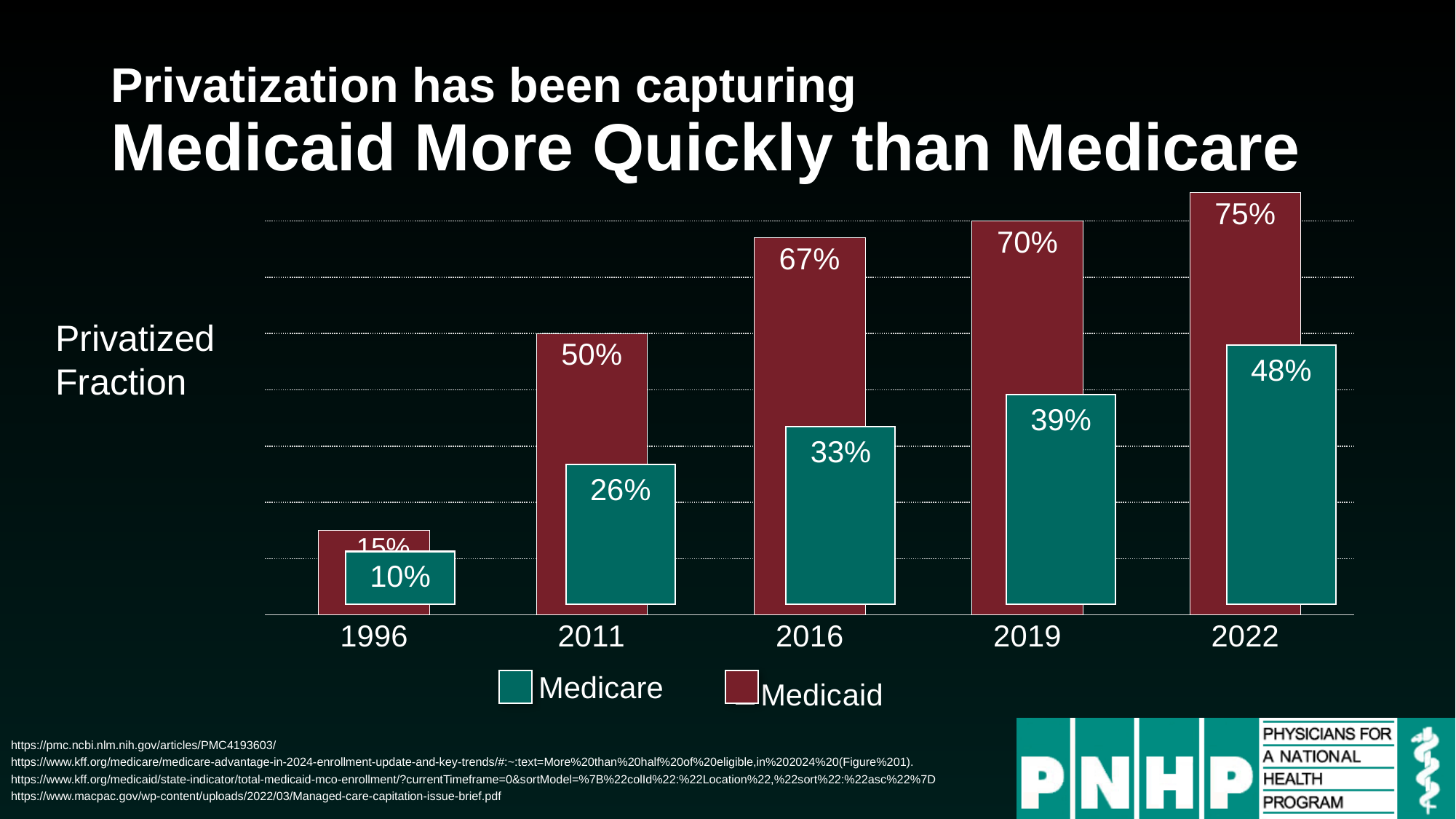
What kind of chart is shown on the slide? Bar chart Does the Medicare privatized fraction rise or fall from 1996 to 2022? Rise What is the Medicaid privatized fraction in 2011? 50% In 2016, which series has the larger privatized fraction, Medicare or Medicaid? Medicaid What is the difference between the Medicaid and Medicare privatized fractions in 2019? 31% In which year is the Medicaid privatized fraction lowest? 1996 How many series does the legend list? 2 What is the Medicare privatized fraction in 1996? 10% In which year is the Medicare privatized fraction highest? 2022 What is the Medicare privatized fraction in 2016? 33% How many years are shown on the x axis of the chart? 5 What is the Medicaid privatized fraction in 2022? 75%